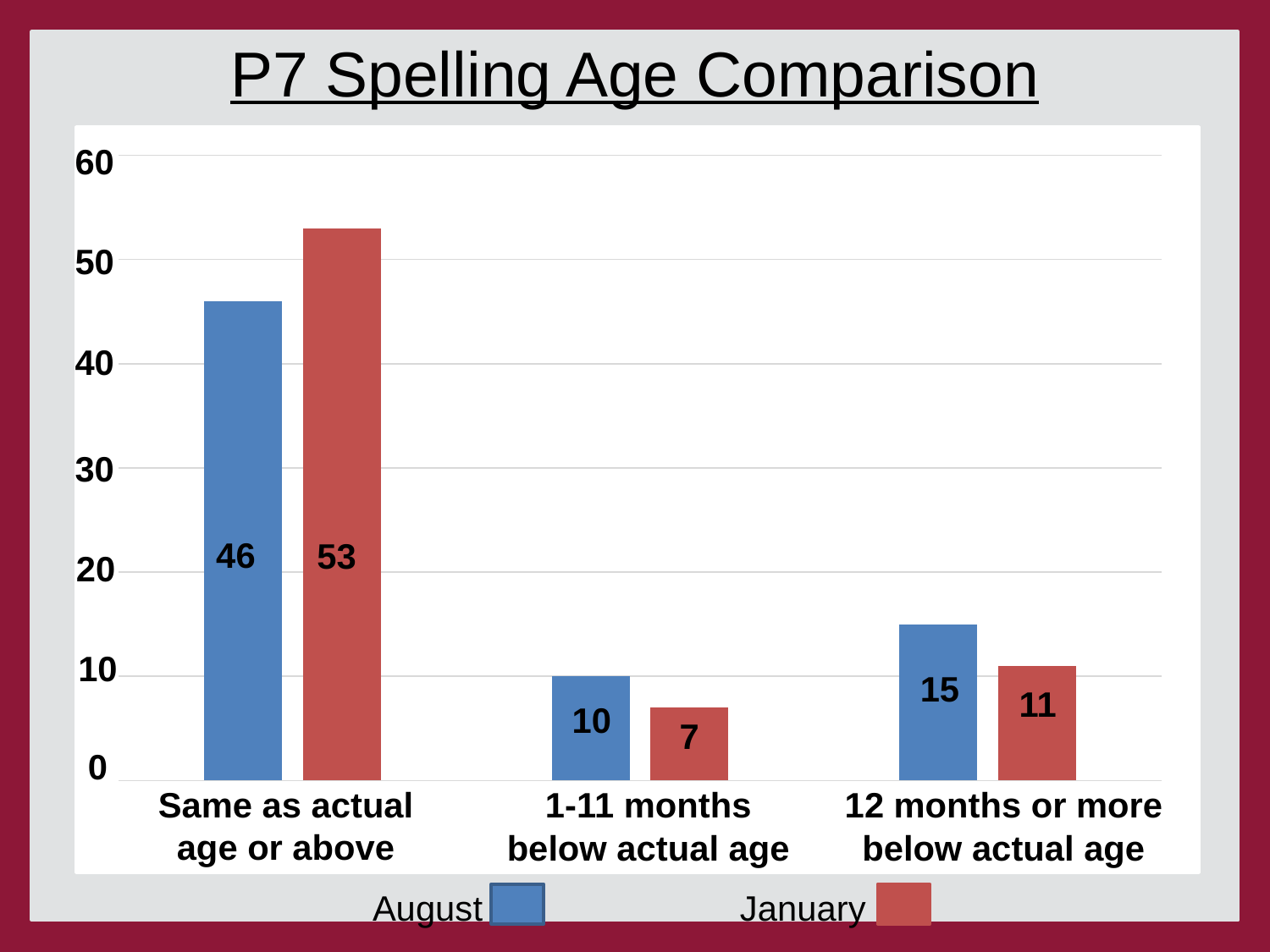
Which category has the highest January value? Same as actual age or above How many series does the legend list? 2 What is the August value for 'Same as actual age or above'? 46 Which is larger for '12 months or more below actual age': the August value or the January value? August What is the difference between the January and August values for 'Same as actual age or above'? 7 What is the January value for '1-11 months below actual age'? 7 What is the title of the chart? P7 Spelling Age Comparison Which category has the lowest August value? 1-11 months below actual age What is the January value for '12 months or more below actual age'? 11 How many categories are shown on the x axis? 3 Is the January value for 'Same as actual age or above' greater or less than 50? greater What kind of chart is shown on the slide? Bar chart